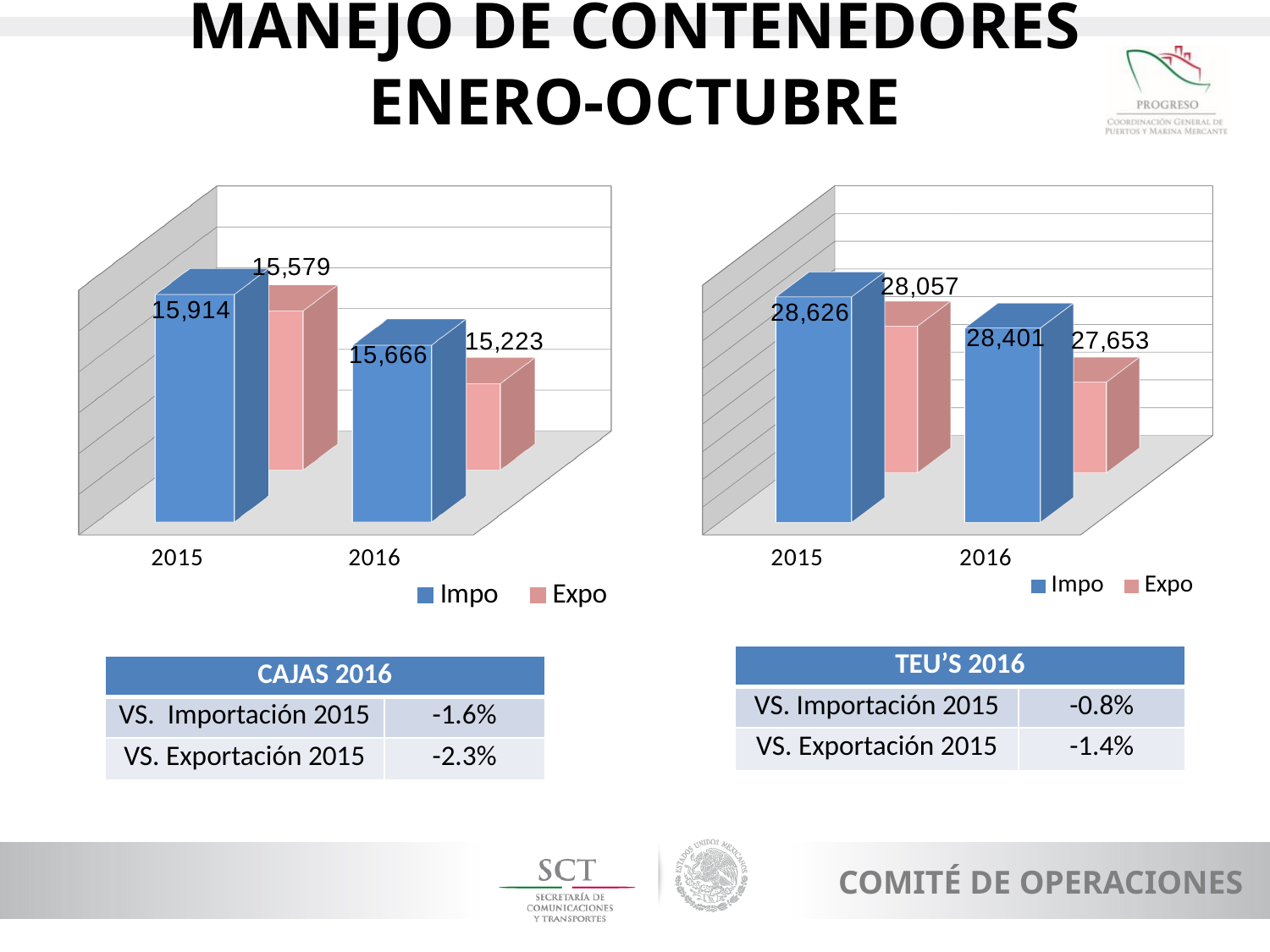
In the right chart, what is the Impo value for 2016? 28,401 In the right chart, which is larger for 2016, Impo or Expo? Impo In the left chart, what is the Impo value for 2015? 15,914 In the right chart, what is the difference between the Expo values for 2015 and 2016? 404 What kind of chart is the right chart? Bar chart In the left chart, what is the difference between the Impo values for 2015 and 2016? 248 In the right chart, what is the Expo value for 2015? 28,057 In the left chart, which bar has the lowest value? Expo 2016 In the left chart, do the Expo values rise or fall from 2015 to 2016? Fall In the right chart, which bar has the highest value? Impo 2015 In the left chart, what is the Expo value for 2016? 15,223 How many series does the legend of the left chart list? 2